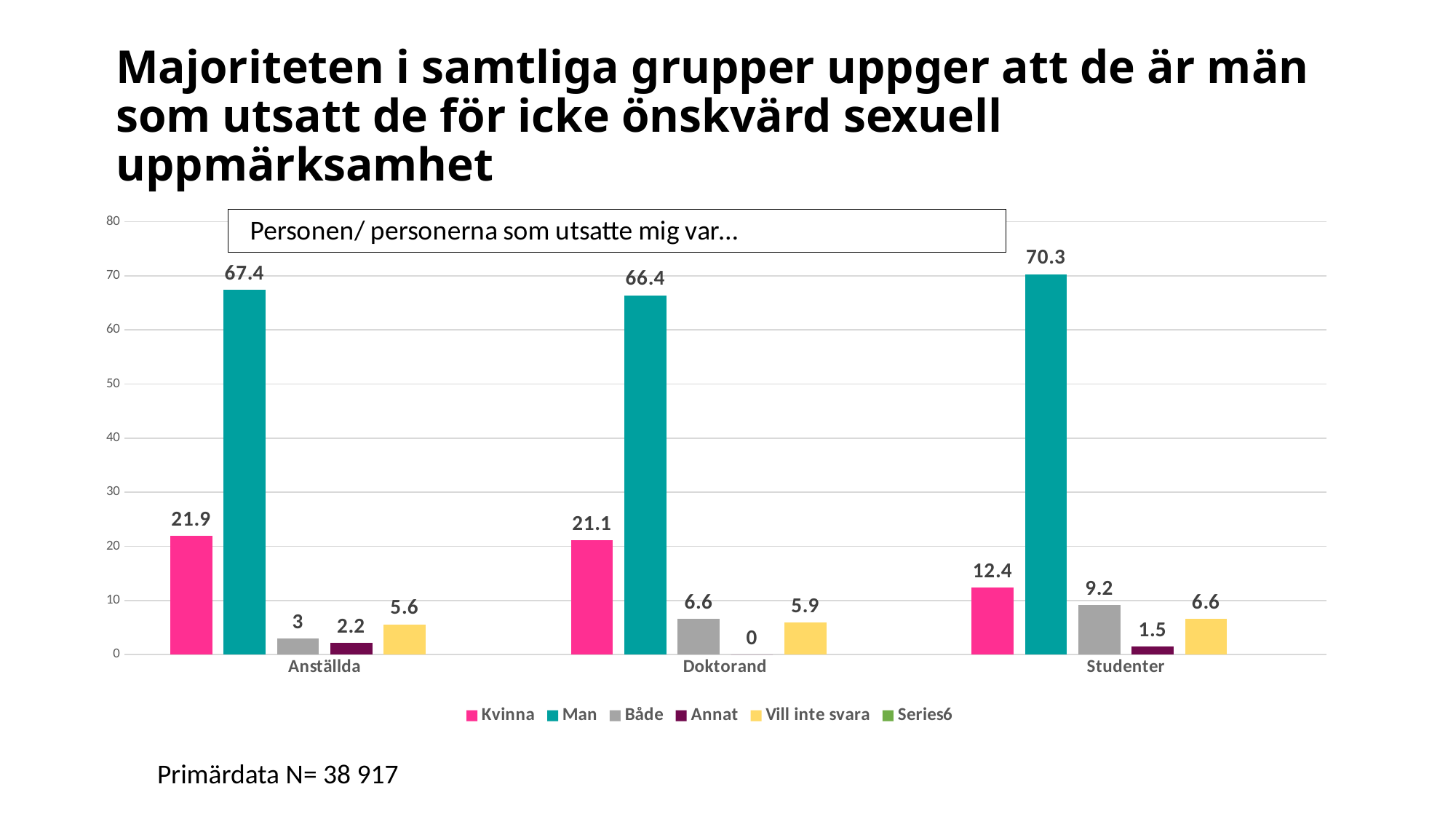
Which group has the lowest value for Kvinna? Studenter What is the value for Både in the Studenter group? 9.2 How many series does the legend list? 6 How many groups are shown on the x axis? 3 What is the difference between the Man value and the Kvinna value in the Anställda group? 45.5 What is the value for Kvinna in the Doktorand group? 21.1 Is the value for Man in the Doktorand group greater or less than 60? greater What is the value for Man in the Anställda group? 67.4 Which group has the highest value for Man? Studenter Which is larger in the Studenter group: Vill inte svara or Annat? Vill inte svara What is the value for Annat in the Doktorand group? 0 What kind of chart is shown on the slide? Bar chart